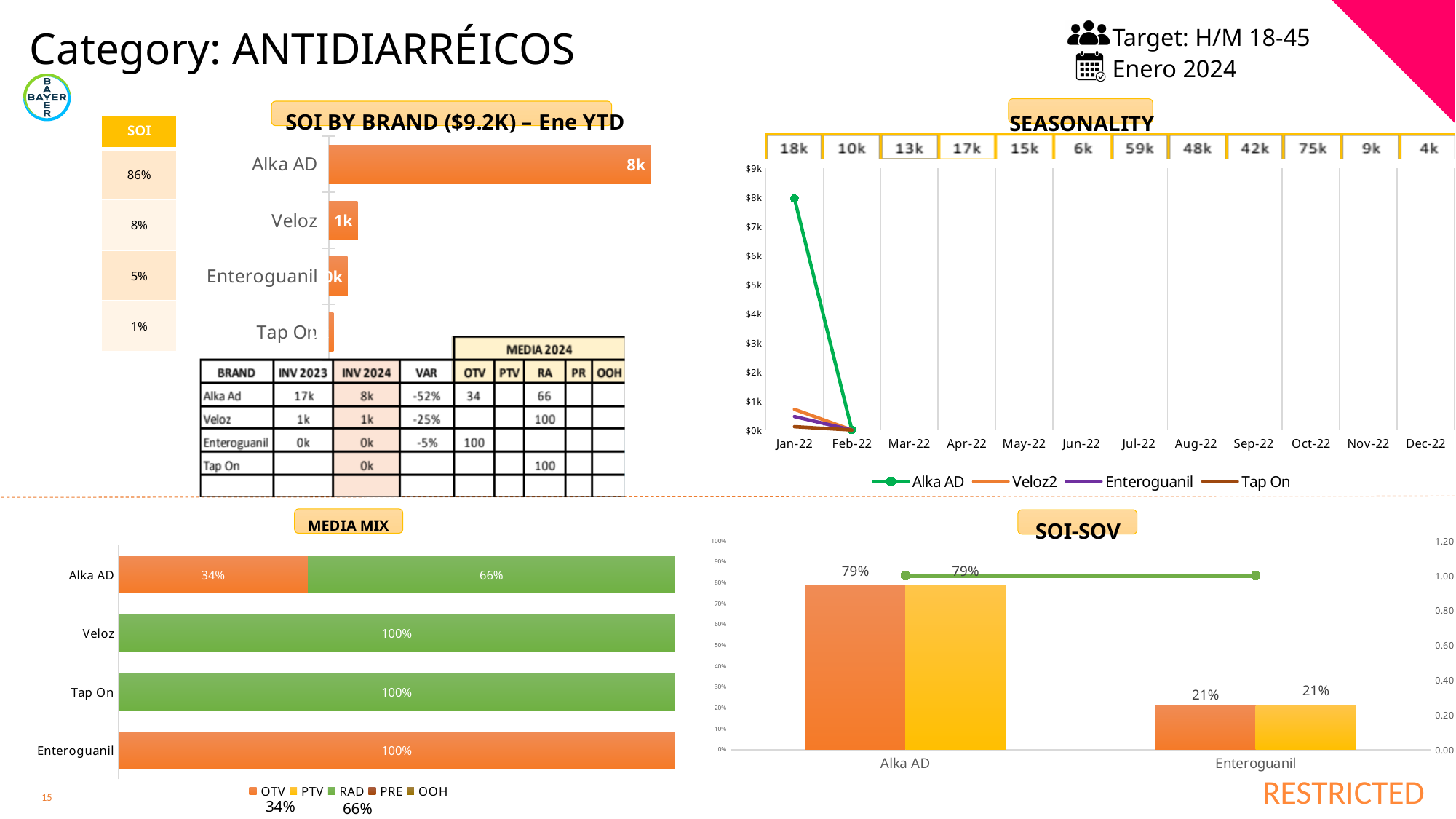
In the SOI-SOV chart, what is the value shown for Enteroguanil? 21% In the SOI BY BRAND chart, what is the value for Veloz? 1k What kind of chart is the SEASONALITY chart? Line chart In the SOI BY BRAND chart, what is the value for Alka AD? 8k In the MEDIA MIX chart, how many series does the legend list? 5 In the SEASONALITY chart, does the Alka AD line rise or fall from Jan-22 to Feb-22? Fall In the SEASONALITY chart, how many series does the legend list? 4 In the MEDIA MIX chart, what is the RAD share for Alka AD? 66% In the SOI BY BRAND chart, how many brands are shown? 4 In the SOI-SOV chart, what is the difference between the Alka AD value and the Enteroguanil value? 58% In the SOI BY BRAND chart, which brand has the highest value? Alka AD In the MEDIA MIX chart, what is the OTV share for Enteroguanil? 100%